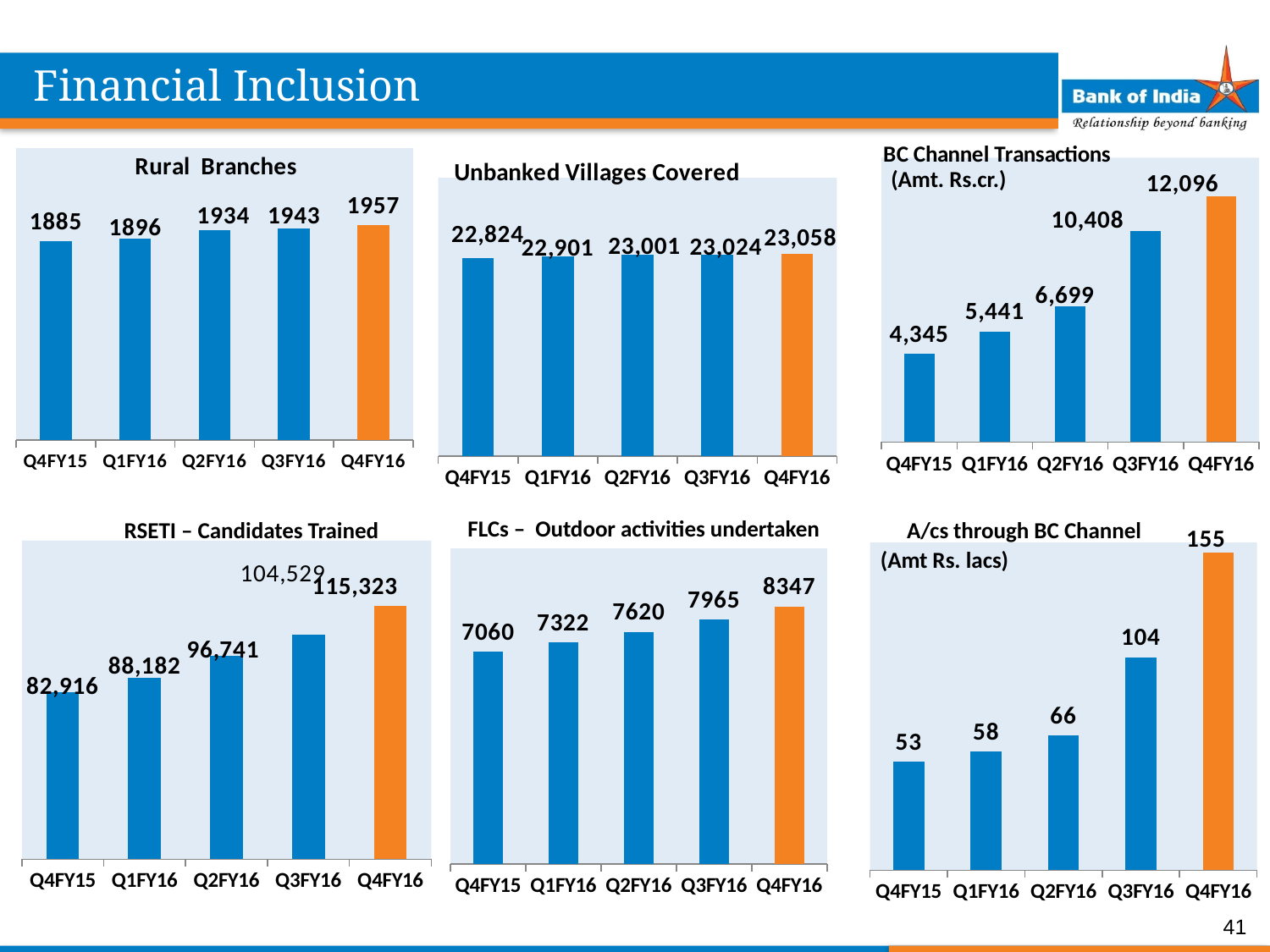
In the Rural Branches chart, what is the difference between Q4FY16 and Q4FY15? 72 In the Unbanked Villages Covered chart, what is the value for Q2FY16? 23,001 In the Rural Branches chart, what is the value for Q4FY16? 1957 In the RSETI – Candidates Trained chart, what is the value for Q1FY16? 88,182 In the FLCs – Outdoor activities undertaken chart, do the values rise or fall from Q4FY15 to Q4FY16? rise What type of chart is the A/cs through BC Channel (Amt Rs. lacs) chart? bar chart In the BC Channel Transactions (Amt. Rs.cr.) chart, what is the difference between Q4FY16 and Q3FY16? 1,688 In the A/cs through BC Channel (Amt Rs. lacs) chart, what is the value for Q2FY16? 66 In the Unbanked Villages Covered chart, how many quarters are shown? 5 In the RSETI – Candidates Trained chart, which quarter has the lowest value? Q4FY15 In the BC Channel Transactions (Amt. Rs.cr.) chart, what is the value for Q3FY16? 10,408 In the BC Channel Transactions (Amt. Rs.cr.) chart, which quarter has the highest value? Q4FY16